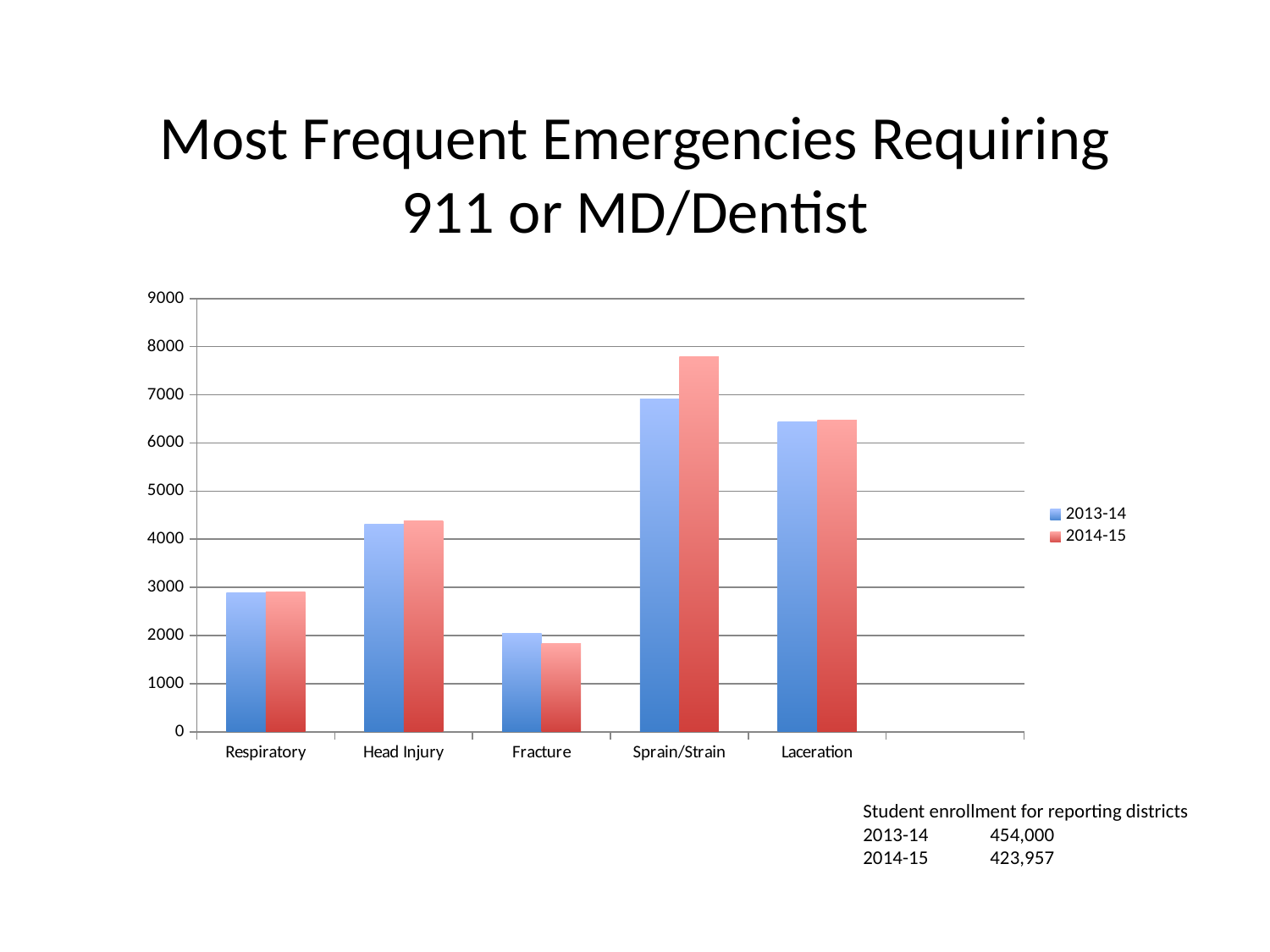
What is the title of the chart? Most Frequent Emergencies Requiring 911 or MD/Dentist Which category has the lowest value for 2013-14? Fracture Is the value for Fracture in 2014-15 greater or less than 2000? less Which category has the lowest value for 2014-15? Fracture For Sprain/Strain, which year has the larger value, 2013-14 or 2014-15? 2014-15 Is the value for Laceration in 2013-14 greater or less than 6000? greater Is the value for Sprain/Strain in 2014-15 greater or less than 7000? greater How many emergency categories are shown on the x axis? 5 Which category has the highest value for 2014-15? Sprain/Strain What kind of chart is shown on the slide? bar chart For Fracture, which year has the larger value, 2013-14 or 2014-15? 2013-14 How many series does the legend list? 2